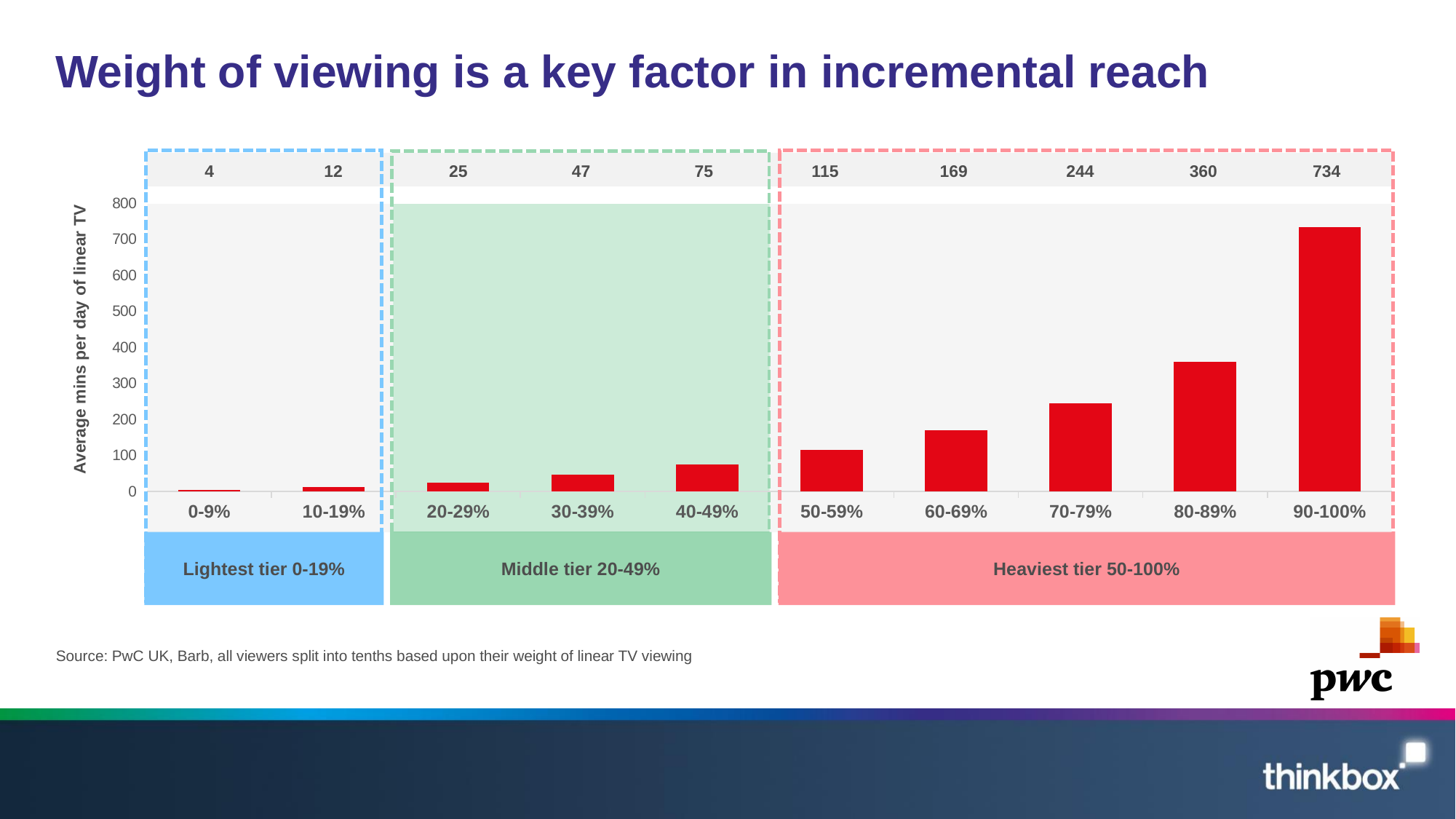
Which group has the highest average minutes per day of linear TV? 90-100% Which is larger, the value for the 40-49% group or the 60-69% group? 60-69% What kind of chart is shown on the slide? Bar chart Which tier label covers the 20-29%, 30-39% and 40-49% groups? Middle tier 20-49% Do the values rise or fall moving from left to right along the x axis? Rise What is the value shown for the 30-39% group? 47 What is the difference between the values for the 90-100% group and the 80-89% group? 374 Which group has the lowest average minutes per day of linear TV? 0-9% What is the average minutes per day of linear TV for the 90-100% group? 734 Is the value for the 70-79% group greater or less than 200? greater How many viewer groups are shown on the x axis? 10 What is the value shown for the 50-59% group? 115